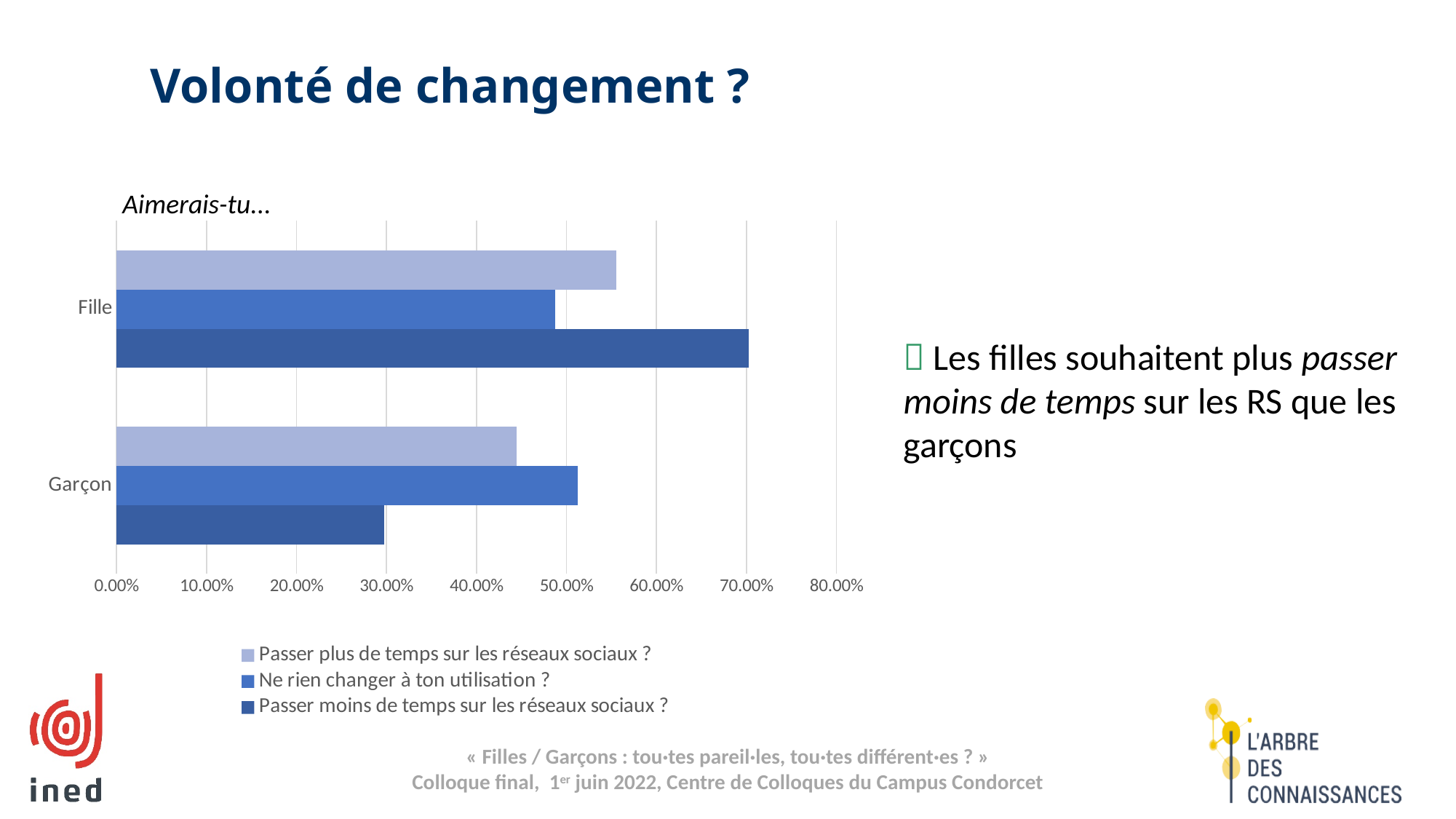
Is the value for Fille in the series "Passer moins de temps sur les réseaux sociaux ?" greater or less than 60.00%? greater What kind of chart is shown on the slide? bar chart For the series "Passer plus de temps sur les réseaux sociaux ?", which category has the larger value, Fille or Garçon? Fille For the category Garçon, which series has the lowest value? Passer moins de temps sur les réseaux sociaux ? How many categories are shown on the vertical axis of the chart? 2 What is the title shown above the chart? Aimerais-tu… Is the value for Garçon in the series "Passer plus de temps sur les réseaux sociaux ?" greater or less than 50.00%? less For the series "Passer moins de temps sur les réseaux sociaux ?", which category has the larger value, Fille or Garçon? Fille Is the value for Garçon in the series "Passer moins de temps sur les réseaux sociaux ?" greater or less than 40.00%? less How many series does the chart legend list? 3 For the category Fille, which series has the highest value? Passer moins de temps sur les réseaux sociaux ?